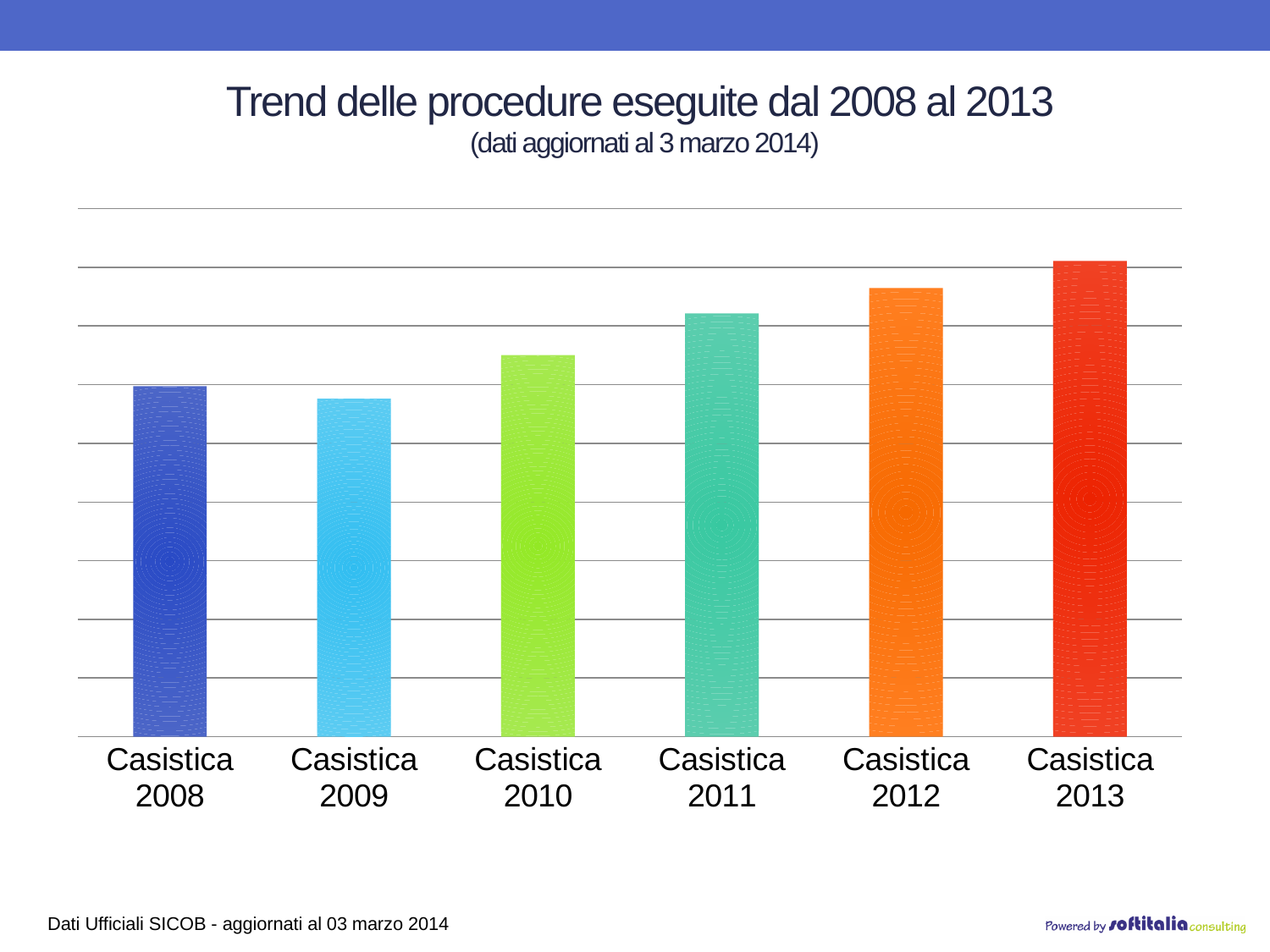
Which category has the highest bar? Casistica 2013 Which is larger, the value for Casistica 2008 or Casistica 2009? Casistica 2008 Do the values generally rise or fall from Casistica 2008 to Casistica 2013? rise What colour is the bar for Casistica 2013? red How many categories (bars) does the chart show? 6 Do the values rise or fall from Casistica 2009 to Casistica 2013? rise Which is larger, the value for Casistica 2012 or Casistica 2013? Casistica 2013 What is the title of the chart on the slide? Trend delle procedure eseguite dal 2008 al 2013 Which category has the lowest bar? Casistica 2009 Which is larger, the value for Casistica 2008 or Casistica 2012? Casistica 2012 What kind of chart is shown on the slide? bar chart